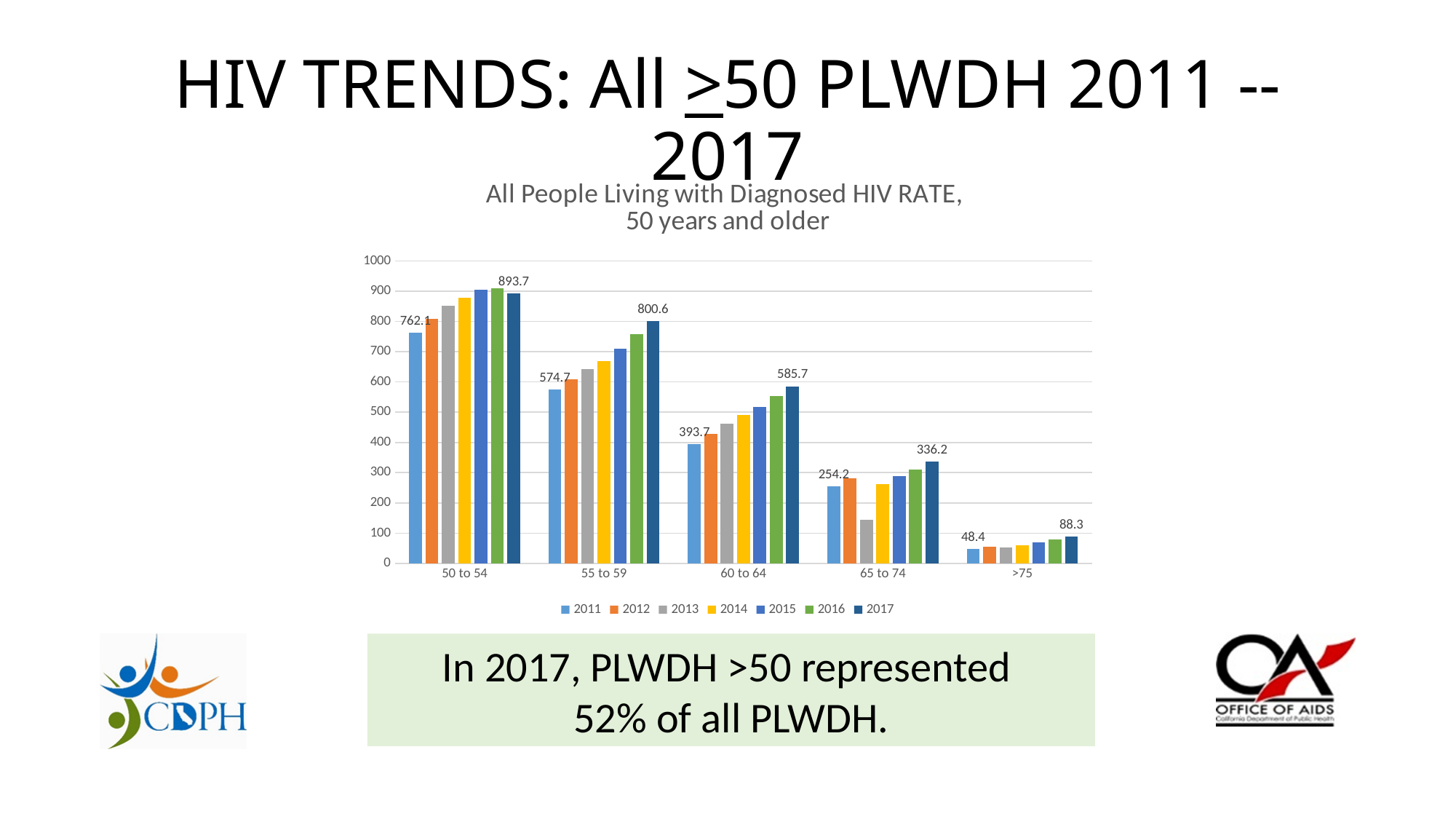
How many age groups are shown on the x axis? 5 What is the 2017 value for the 55 to 59 age group? 800.6 What kind of chart is shown on the slide? Bar chart How many series does the legend list? 7 Which age group has the lowest 2011 value? >75 What is the 2011 value for the >75 age group? 48.4 Which age group has the highest 2017 value? 50 to 54 Is the 2013 value for the 65 to 74 age group greater or less than 200? less What is the 2017 value for the 65 to 74 age group? 336.2 What is the 2011 value for the 50 to 54 age group? 762.1 Which is larger: the 2011 value for 50 to 54 or the 2017 value for 55 to 59? 2017 value for 55 to 59 For the 60 to 64 age group, how much higher is the 2017 value than the 2011 value? 192.0